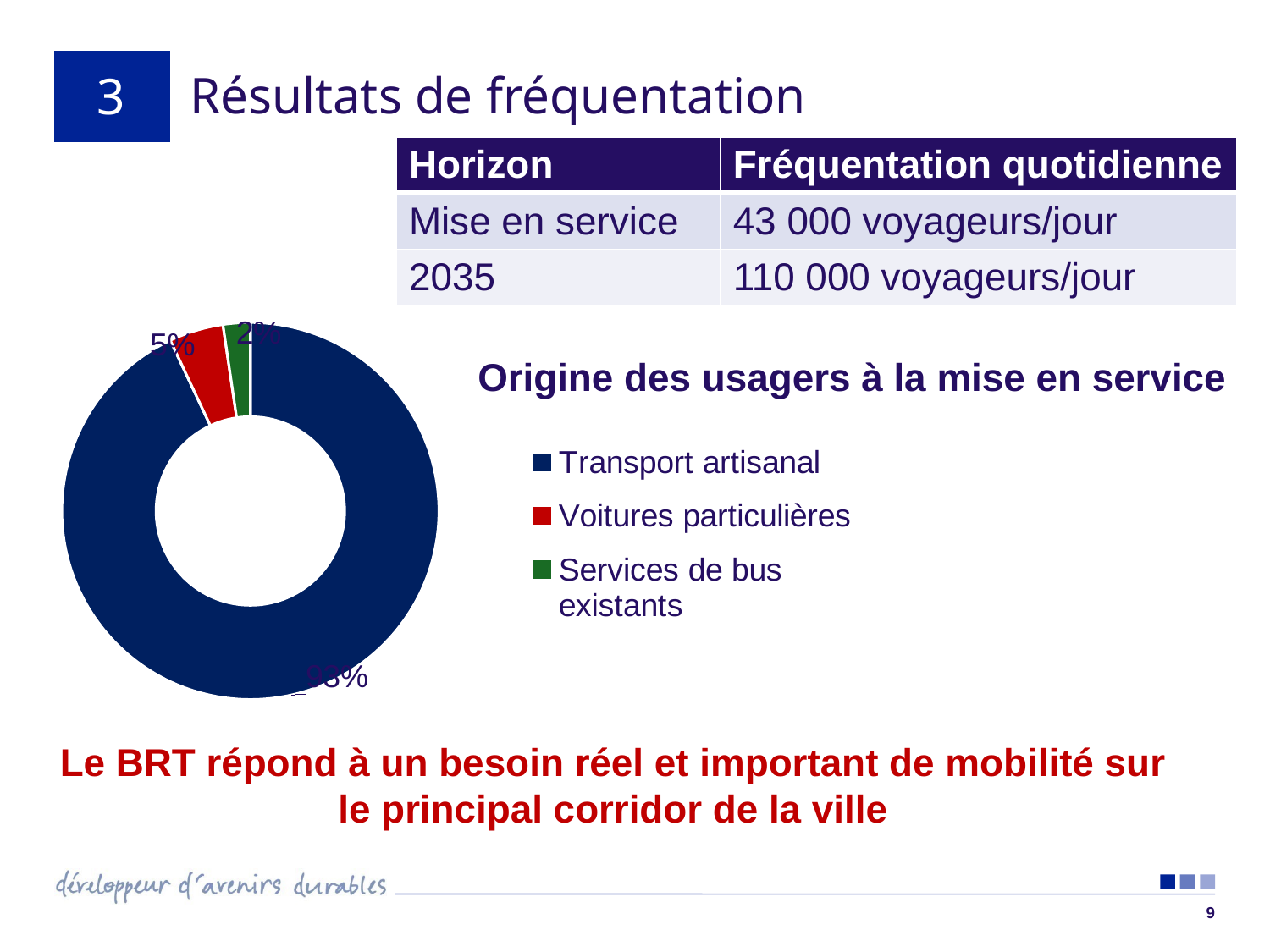
What colour represents Transport artisanal in the chart? dark blue Which is larger: the share for Voitures particulières or the share for Services de bus existants? Voitures particulières What share of users comes from Voitures particulières? 5% How many categories does the legend of the chart list? 3 Which category has the smallest share in the chart? Services de bus existants How many slices does the doughnut chart have? 3 Which category has the largest share in the chart? Transport artisanal What share of users comes from Transport artisanal? 93% What is the title of the chart? Origine des usagers à la mise en service What is the difference between the share for Voitures particulières and the share for Services de bus existants? 3% What kind of chart is shown on the slide? doughnut chart What share of users comes from Services de bus existants? 2%